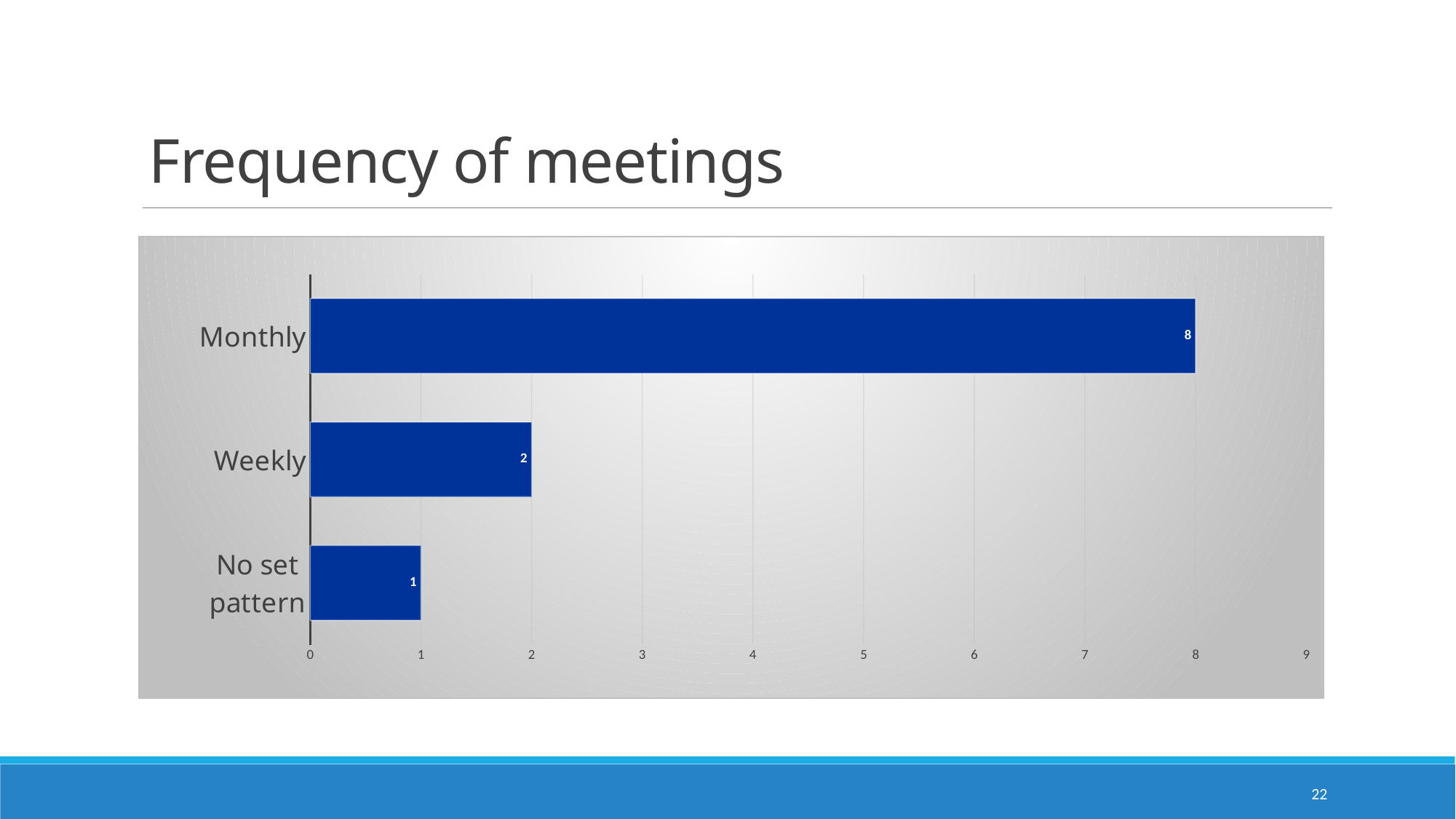
Which is larger, the value for Weekly or the value for No set pattern? Weekly What is the value for Weekly? 2 What kind of chart is shown on the slide? bar chart What is the value for No set pattern? 1 Which category has the highest value? Monthly What is the difference between the values for Weekly and No set pattern? 1 How many categories are shown in the chart? 3 What is the value for Monthly? 8 What is the title of the slide containing the chart? Frequency of meetings Is the value for Monthly greater or less than 5? greater What is the difference between the values for Monthly and Weekly? 6 Which category has the lowest value? No set pattern